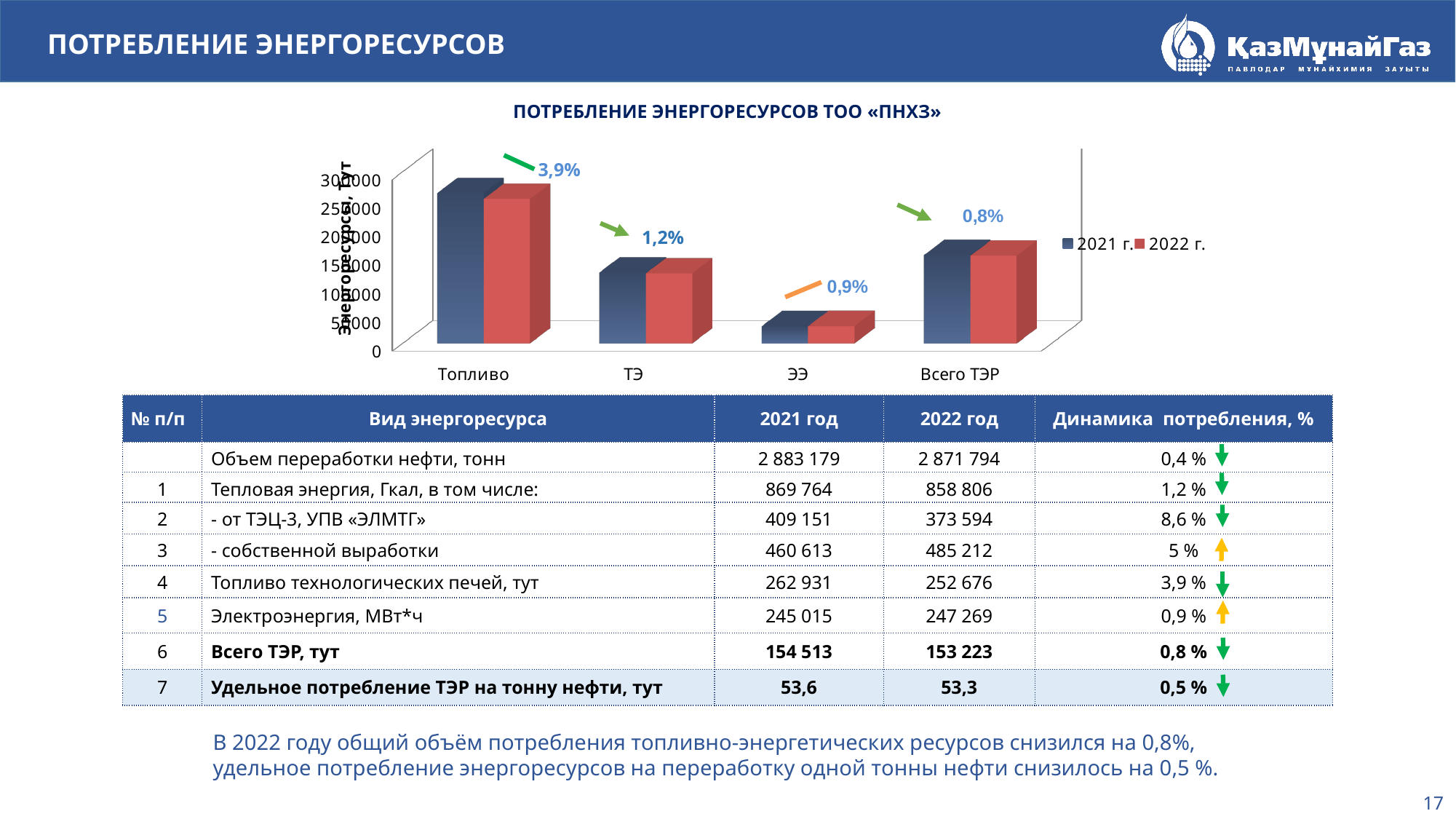
What percentage change is labelled above the ТЭ bars? 1,2% What kind of chart is shown on the slide? bar chart Is the 2021 г. value for Топливо greater or less than 250000? greater What percentage change is labelled above the Всего ТЭР bars? 0,8% What is the title of the chart? ПОТРЕБЛЕНИЕ ЭНЕРГОРЕСУРСОВ ТОО «ПНХЗ» Which category has the lowest bars in the chart? ЭЭ Which category has the highest bars in the chart? Топливо Is the 2021 г. value for ЭЭ greater or less than 100000? less How many series does the chart legend list? 2 How many categories are shown on the x axis of the chart? 4 Which is larger in the chart: the 2021 г. bar for ТЭ or the 2021 г. bar for ЭЭ? ТЭ What percentage change is labelled above the Топливо bars? 3,9%